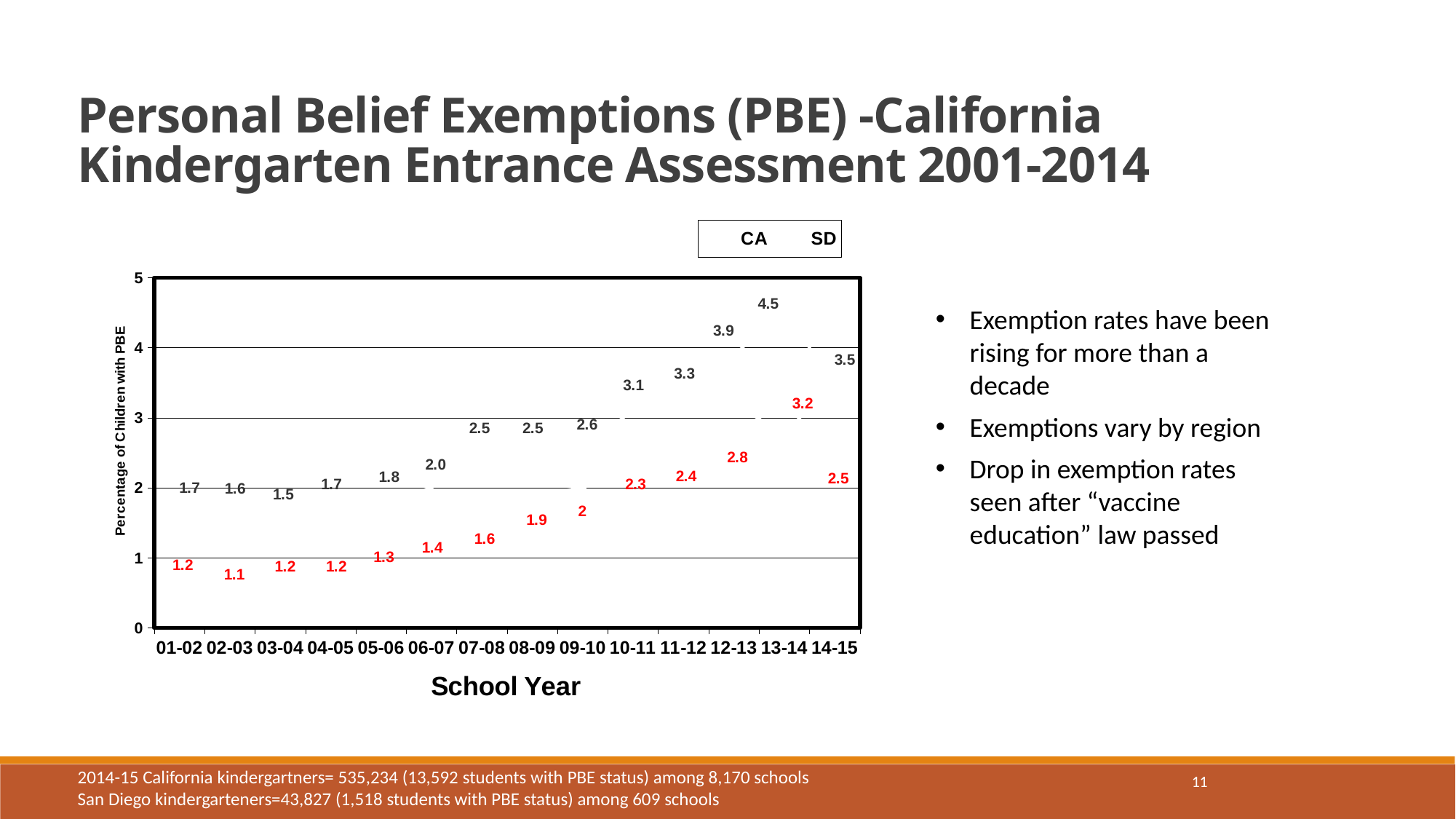
Do the CA values generally rise or fall from 01-02 to 13-14? rise How many school years are shown on the x axis? 14 In which school year is the CA value highest? 13-14 Which series has the larger value in the 12-13 school year, CA or SD? SD What is the title of the y axis? Percentage of Children with PBE What is the CA value for the 06-07 school year? 1.4 By how much did the SD value fall from 13-14 to 14-15? 1.0 What is the difference between the CA and SD values in the 13-14 school year? 1.3 In which school year is the SD value lowest? 03-04 What is the CA value for the 13-14 school year? 3.2 How many series does the legend list? 2 What is the SD value for the 14-15 school year? 3.5